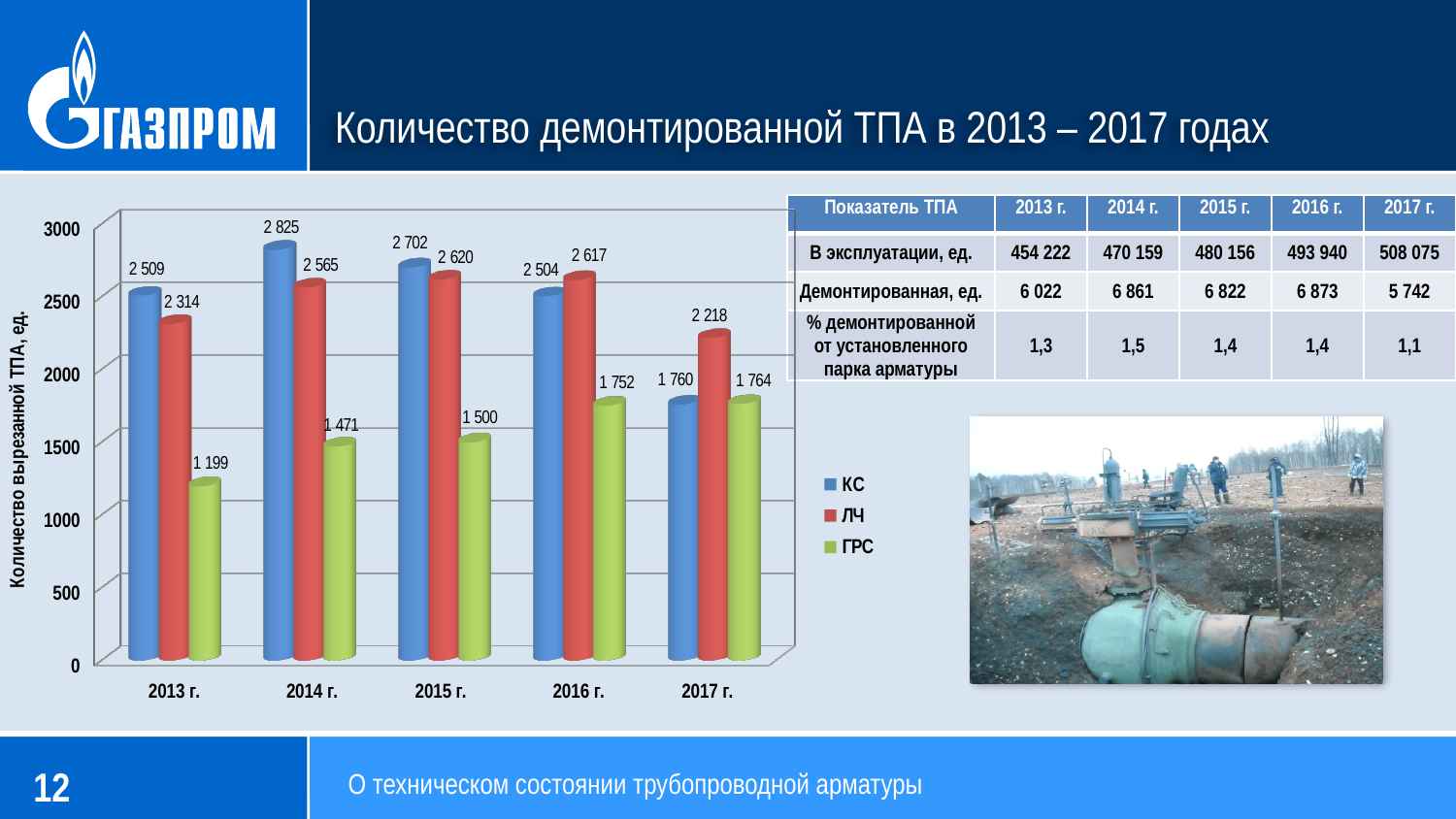
What is the value for ГРС in 2015 г.? 1 500 What is the value for ЛЧ in 2017 г.? 2 218 How many series does the chart legend list? 3 In which year is the ГРС value lowest? 2013 г. What kind of chart is shown on the slide? bar chart What is the value for КС in 2013 г.? 2 509 How many years are shown on the x axis of the chart? 5 In which year is the КС value highest? 2014 г. Which is larger in 2016 г., the КС value or the ЛЧ value? ЛЧ Is the value for ГРС in 2014 г. greater or less than 1500? less What is the y-axis label of the chart? Количество вырезанной ТПА, ед. What is the difference between the КС and ЛЧ values in 2014 г.? 260